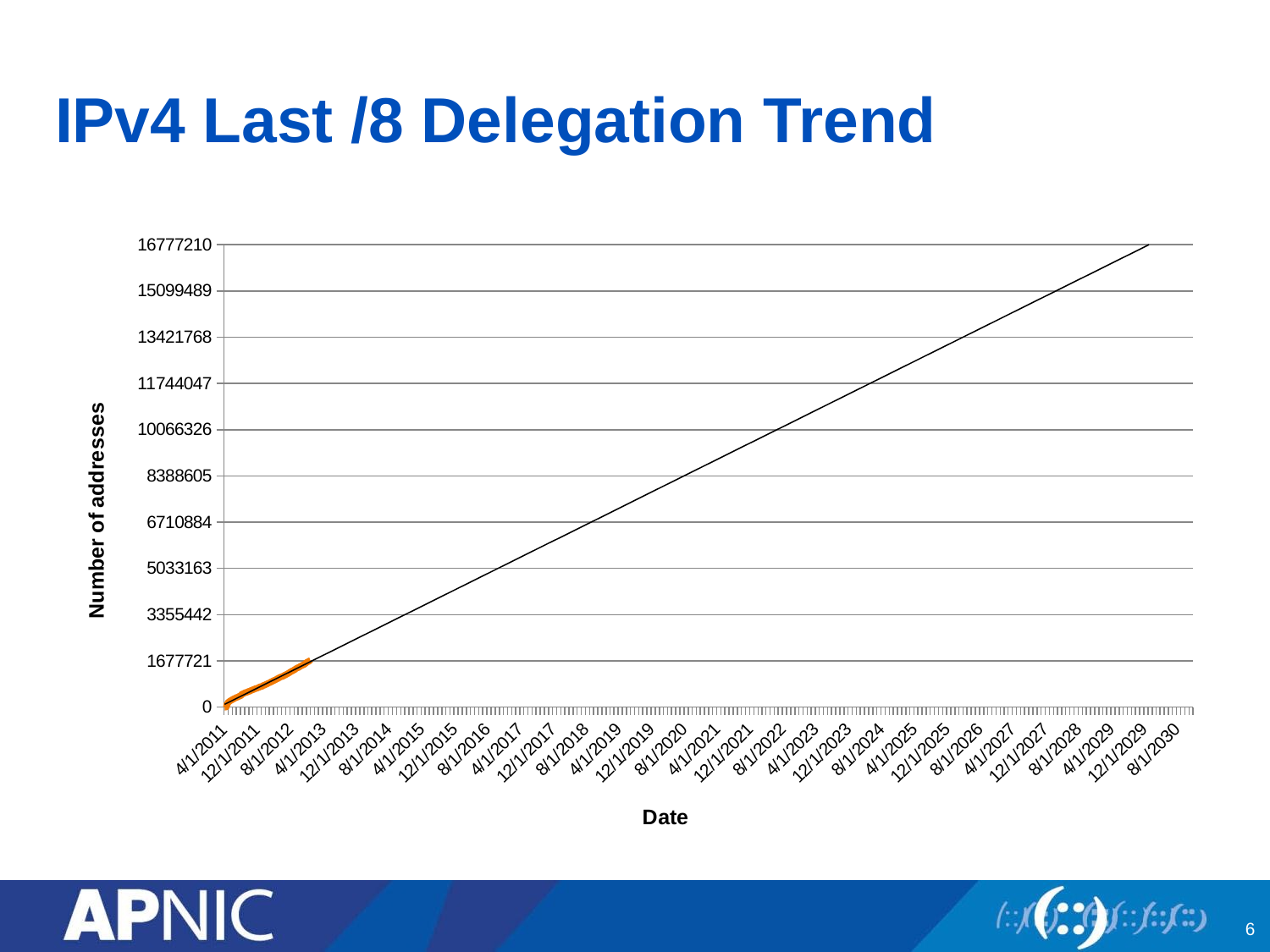
Is the value for 8/1/2026 greater or less than 11744047? greater What is the label on the vertical axis of the chart? Number of addresses Does the number of addresses rise or fall as the date moves from 4/1/2011 to 8/1/2030? rise What kind of chart is shown on the slide? line chart What is the highest tick value shown on the vertical axis? 16777210 Is the value for 4/1/2015 greater or less than 5033163? less Is the value for 4/1/2013 greater or less than 3355442? less At which end of the date axis does the line reach its highest value? 8/1/2030 Which date has the larger value, 4/1/2014 or 8/1/2028? 8/1/2028 At which end of the date axis does the line reach its lowest value? 4/1/2011 What is the title of the chart? IPv4 Last /8 Delegation Trend